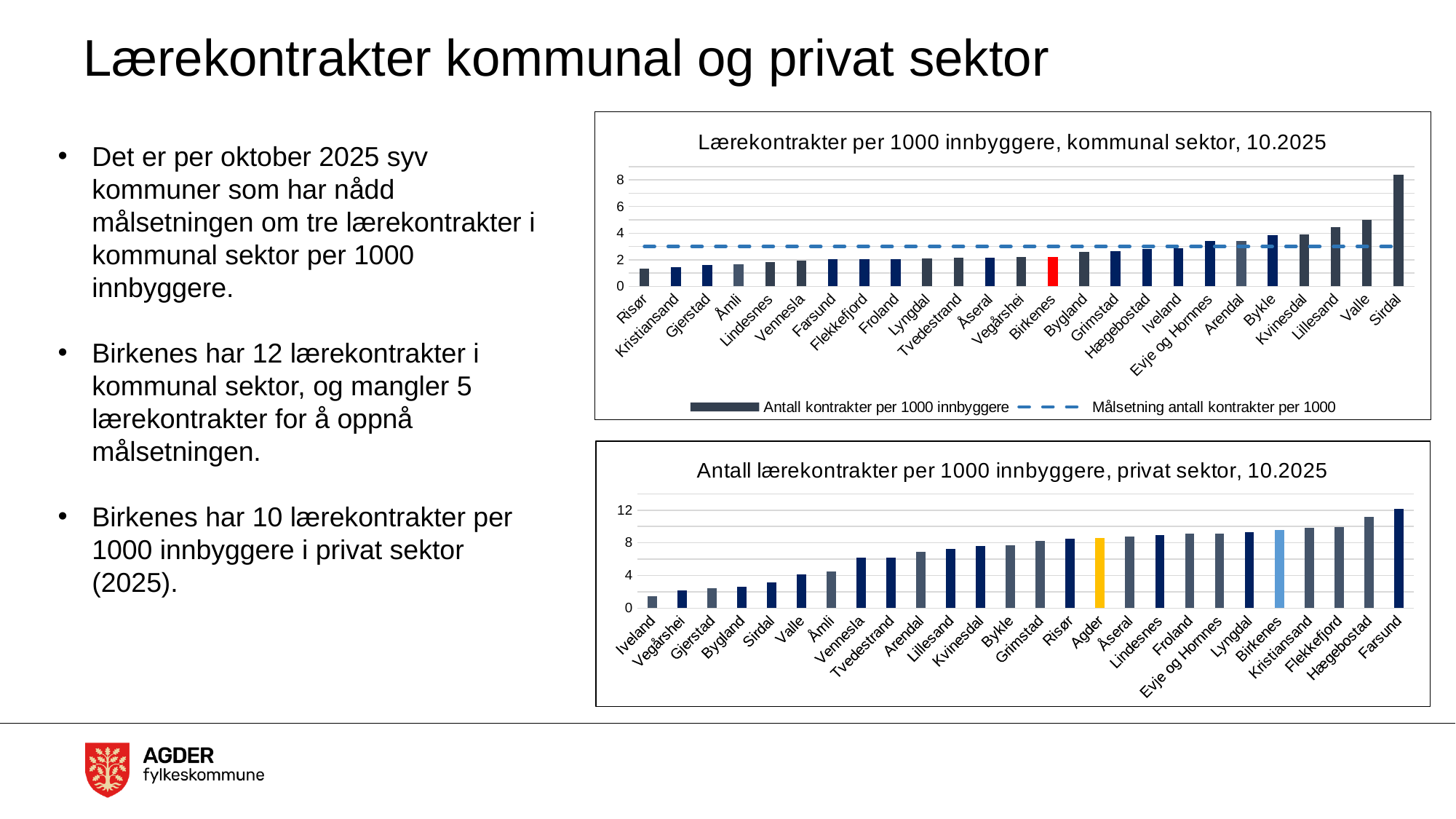
In the top chart (kommunal sektor), which municipality has the lowest value? Risør What kind of chart is the top chart, 'Lærekontrakter per 1000 innbyggere, kommunal sektor, 10.2025'? Combination bar and line chart (bars with a dashed target line) How many series does the legend of the top chart (kommunal sektor) list? 2 In the bottom chart (privat sektor), which municipality has the lowest value? Iveland In the top chart (kommunal sektor), which municipality has the highest value? Sirdal In the top chart (kommunal sektor), what does the dashed line represent? Målsetning antall kontrakter per 1000 In the top chart (kommunal sektor), is the value for Sirdal greater or less than 6? greater In the bottom chart (privat sektor), which has the larger value, Sirdal or Lyngdal? Lyngdal In the bottom chart (privat sektor), do the values rise or fall from left to right along the x axis? Rise In the top chart (kommunal sektor), is the value for Risør greater or less than 2? less In the bottom chart (privat sektor), is the value for Birkenes greater or less than 8? greater In the bottom chart (privat sektor), which municipality has the highest value? Farsund